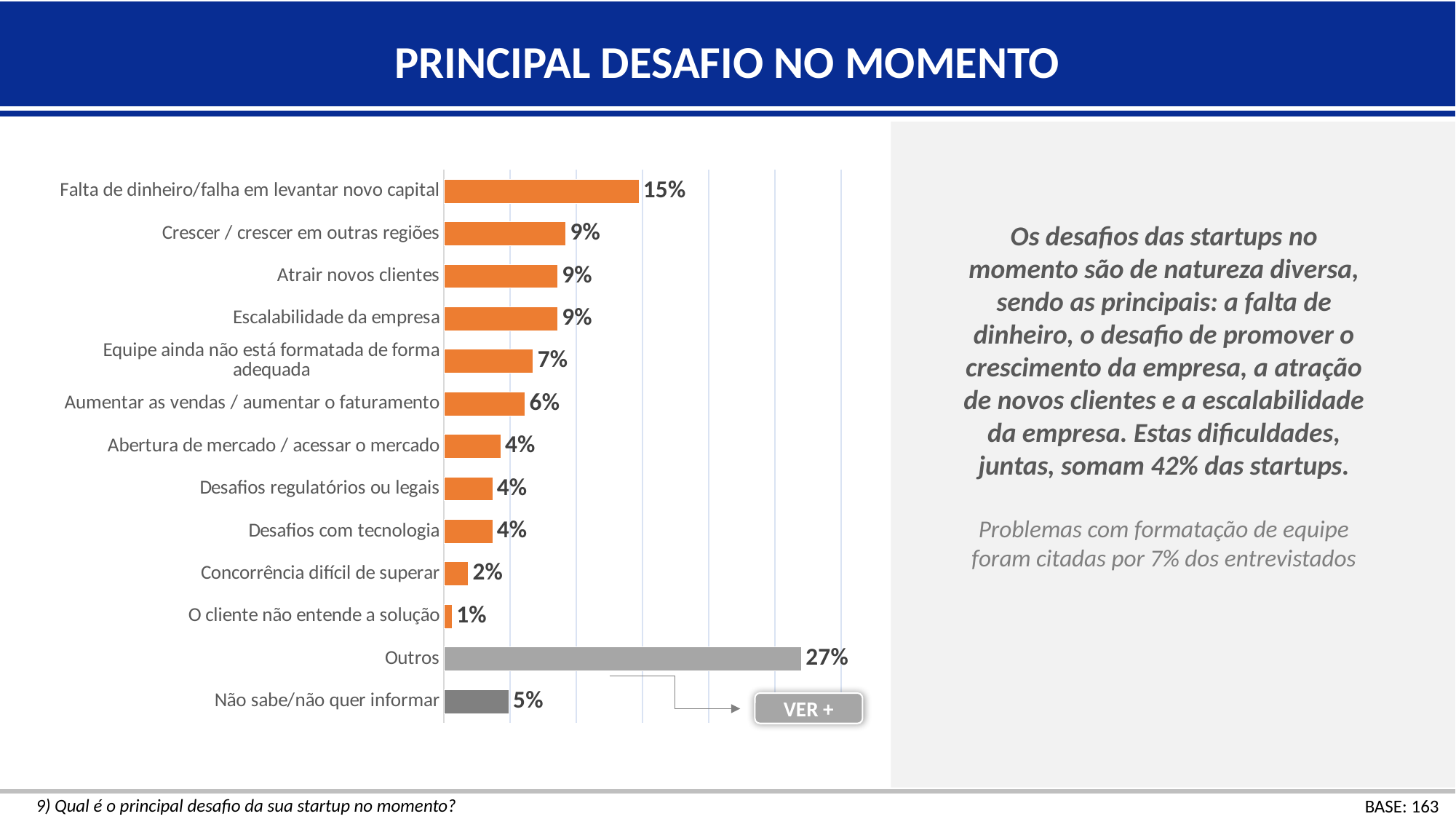
Which category has the lowest value in the chart? O cliente não entende a solução What kind of chart is shown on the slide? Bar chart What value is shown for "Não sabe/não quer informar"? 5% What percentage is shown for "Falta de dinheiro/falha em levantar novo capital"? 15% Which category has the highest value in the chart? Outros What percentage is shown for "Outros"? 27% What is the title of the slide containing the chart? PRINCIPAL DESAFIO NO MOMENTO Which is larger: the value for "Aumentar as vendas / aumentar o faturamento" or the value for "Abertura de mercado / acessar o mercado"? Aumentar as vendas / aumentar o faturamento What is the difference between the values for "Falta de dinheiro/falha em levantar novo capital" and "Crescer / crescer em outras regiões"? 6 percentage points What is the combined value of "Falta de dinheiro/falha em levantar novo capital", "Crescer / crescer em outras regiões", "Atrair novos clientes" and "Escalabilidade da empresa"? 42% What value is shown for "Equipe ainda não está formatada de forma adequada"? 7% How many categories are plotted in the chart? 13